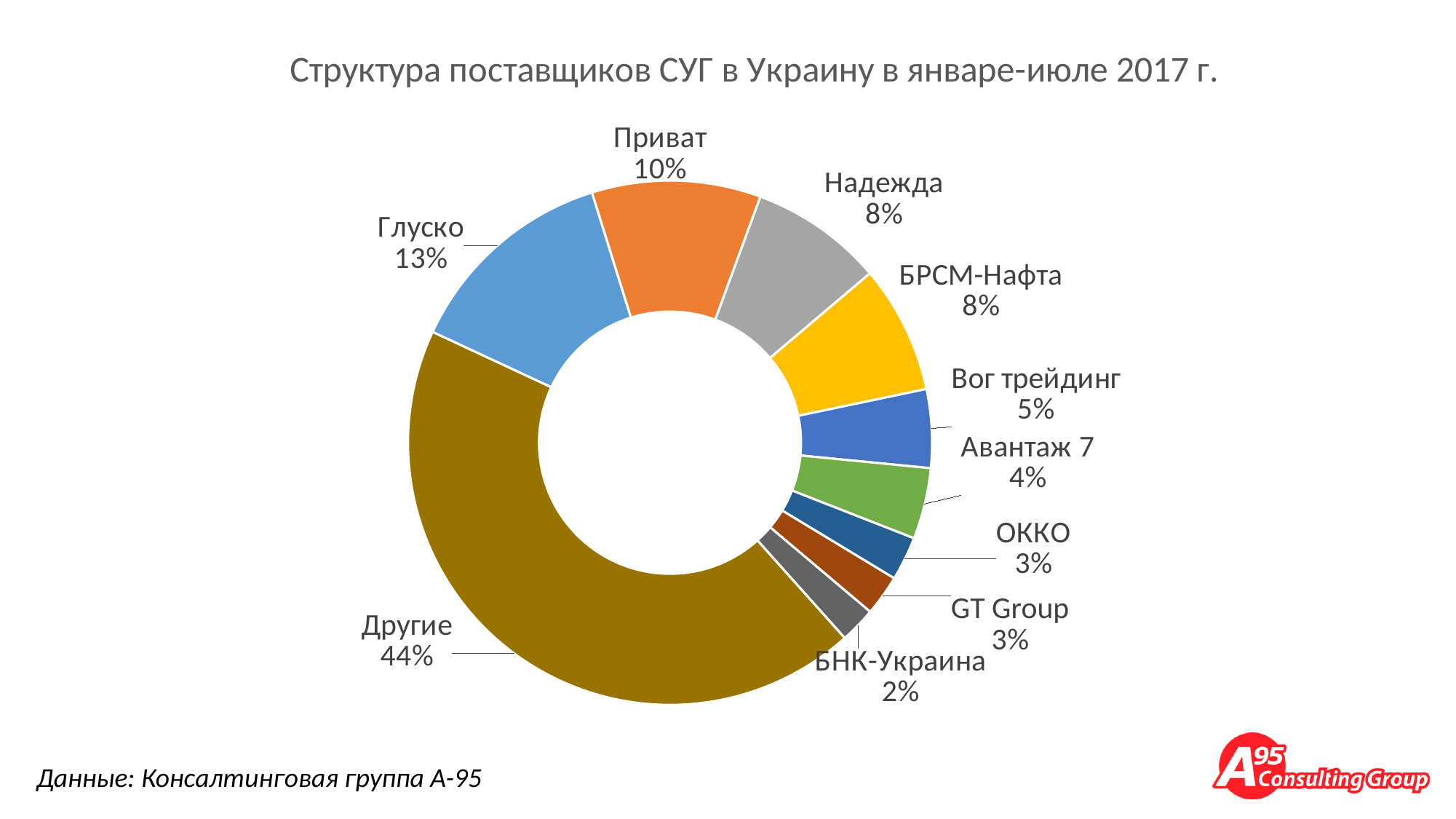
What is the value for БНК-Украина? 2% Which is larger, the share of Приват or the share of Надежда? Приват What is the combined share of Надежда and БРСМ-Нафта? 16% What is the title of the chart? Структура поставщиков СУГ в Украину в январе-июле 2017 г. What percentage is shown for Вог трейдинг? 5% How many categories are shown in the chart? 10 Which category has the largest share in the chart? Другие Which category has the smallest share in the chart? БНК-Украина What share does Глуско hold in the chart? 13% What is the value shown for Приват? 10% What is the difference between the shares of Другие and Глуско? 31 percentage points What kind of chart is shown on the slide? Doughnut (pie) chart